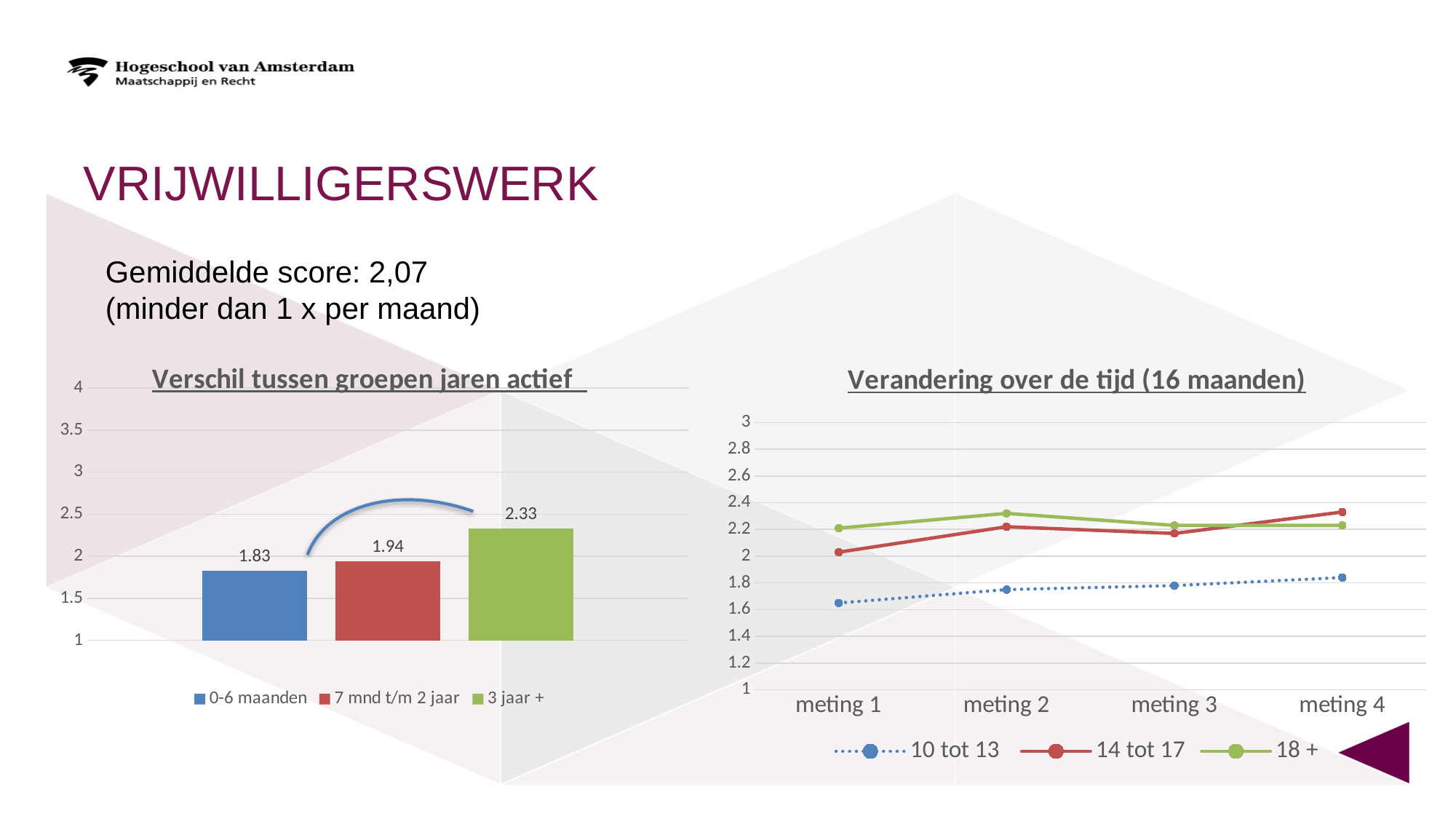
In the chart 'Verschil tussen groepen jaren actief', which group has the highest value? 3 jaar + In the chart 'Verschil tussen groepen jaren actief', what is the difference between the values for '3 jaar +' and '7 mnd t/m 2 jaar'? 0.39 In the chart 'Verschil tussen groepen jaren actief', how many bars are shown? 3 In the chart 'Verschil tussen groepen jaren actief', what is the value for '3 jaar +'? 2.33 In the chart 'Verschil tussen groepen jaren actief', what is the value for '0-6 maanden'? 1.83 What kind of chart is 'Verandering over de tijd (16 maanden)'? line chart In the chart 'Verschil tussen groepen jaren actief', which group has the lowest value? 0-6 maanden In the chart 'Verandering over de tijd (16 maanden)', how many series does the legend list? 3 In the chart 'Verandering over de tijd (16 maanden)', does the '10 tot 13' series rise or fall from meting 1 to meting 4? rise What kind of chart is 'Verschil tussen groepen jaren actief'? bar chart In the chart 'Verandering over de tijd (16 maanden)', is the value for '10 tot 13' at meting 1 greater or less than 1.8? less In the chart 'Verandering over de tijd (16 maanden)', which series has the lowest value at meting 4? 10 tot 13